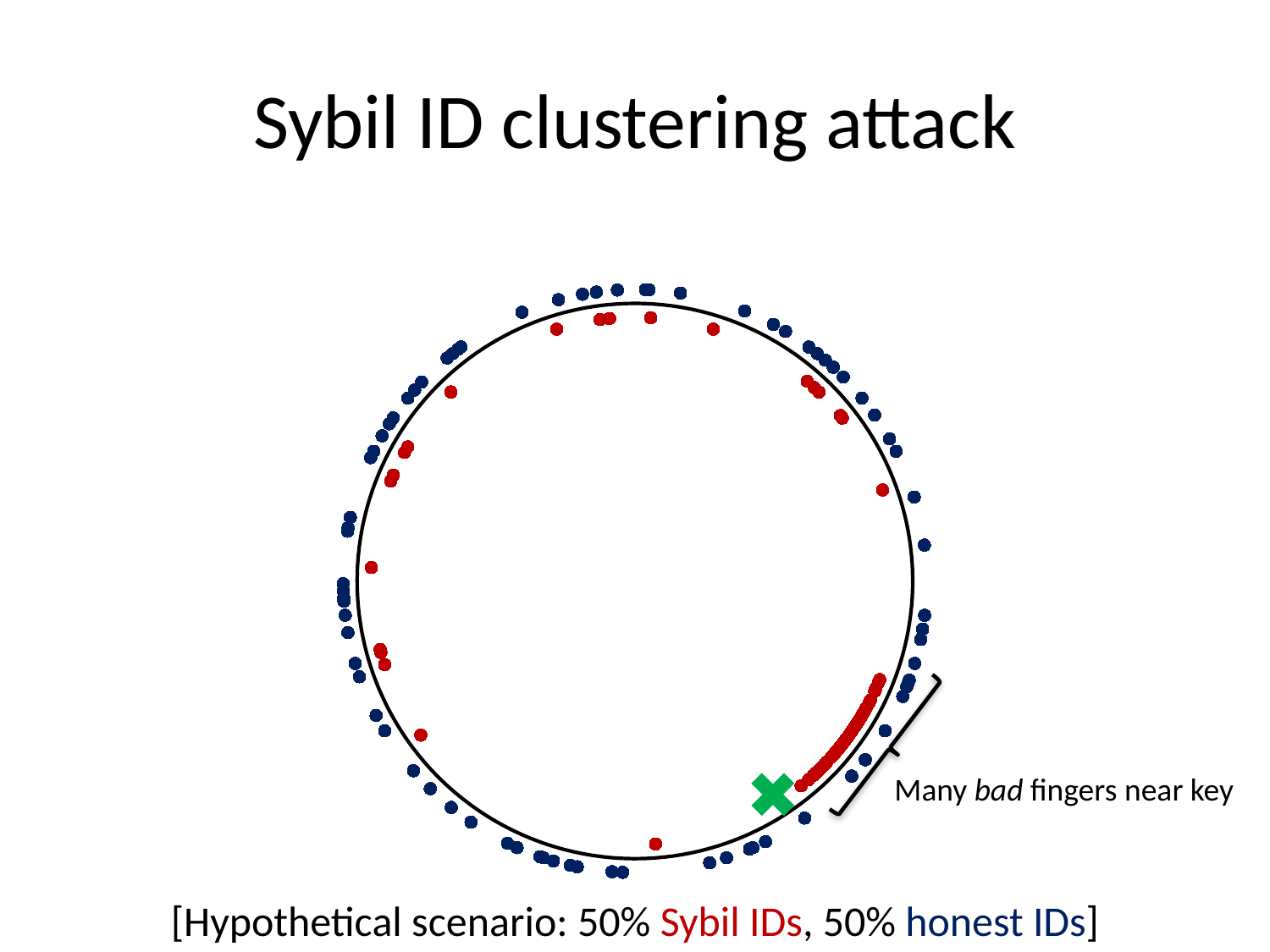
What does the annotation next to the bracketed cluster near the green X say? Many bad fingers near key According to the hypothetical scenario stated on the slide, what percentage of IDs are honest IDs? 50% According to the hypothetical scenario stated on the slide, what percentage of IDs are Sybil IDs? 50% What colour are the Sybil IDs drawn in on the ring diagram? red